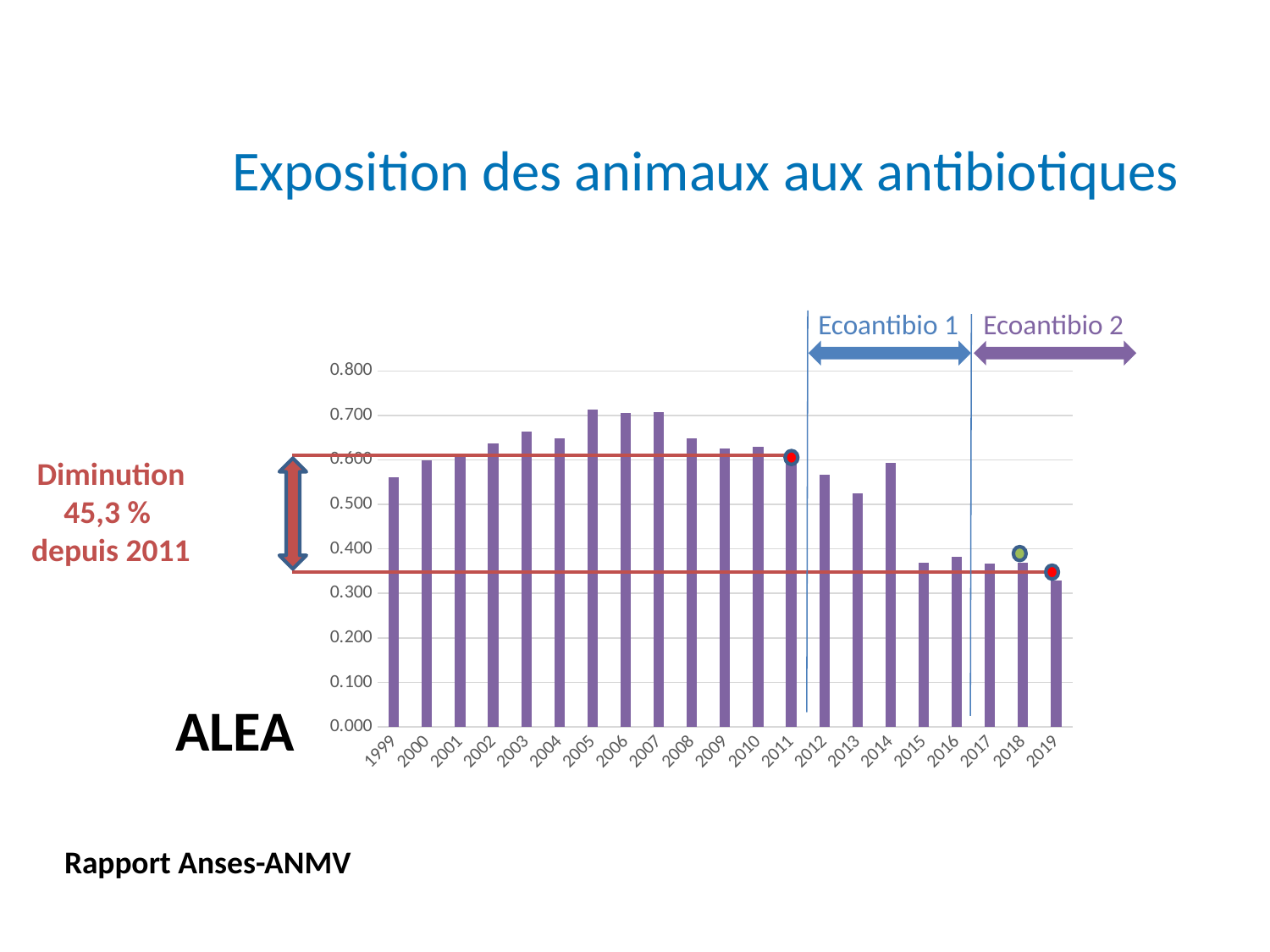
Which year has the larger value, 2013 or 2014? 2014 Is the value for 1999 greater or less than 0.600? less What kind of chart is shown on the slide? bar chart Do the values generally rise or fall from 2011 to 2019? fall What is the title of the slide containing the chart? Exposition des animaux aux antibiotiques What percentage decrease since 2011 is annotated next to the chart? 45,3 % Is the value for 2015 greater or less than 0.400? less Which year has the lowest bar in the chart? 2019 Is the value for 2013 greater or less than 0.500? greater How many years are shown on the x axis of the chart? 21